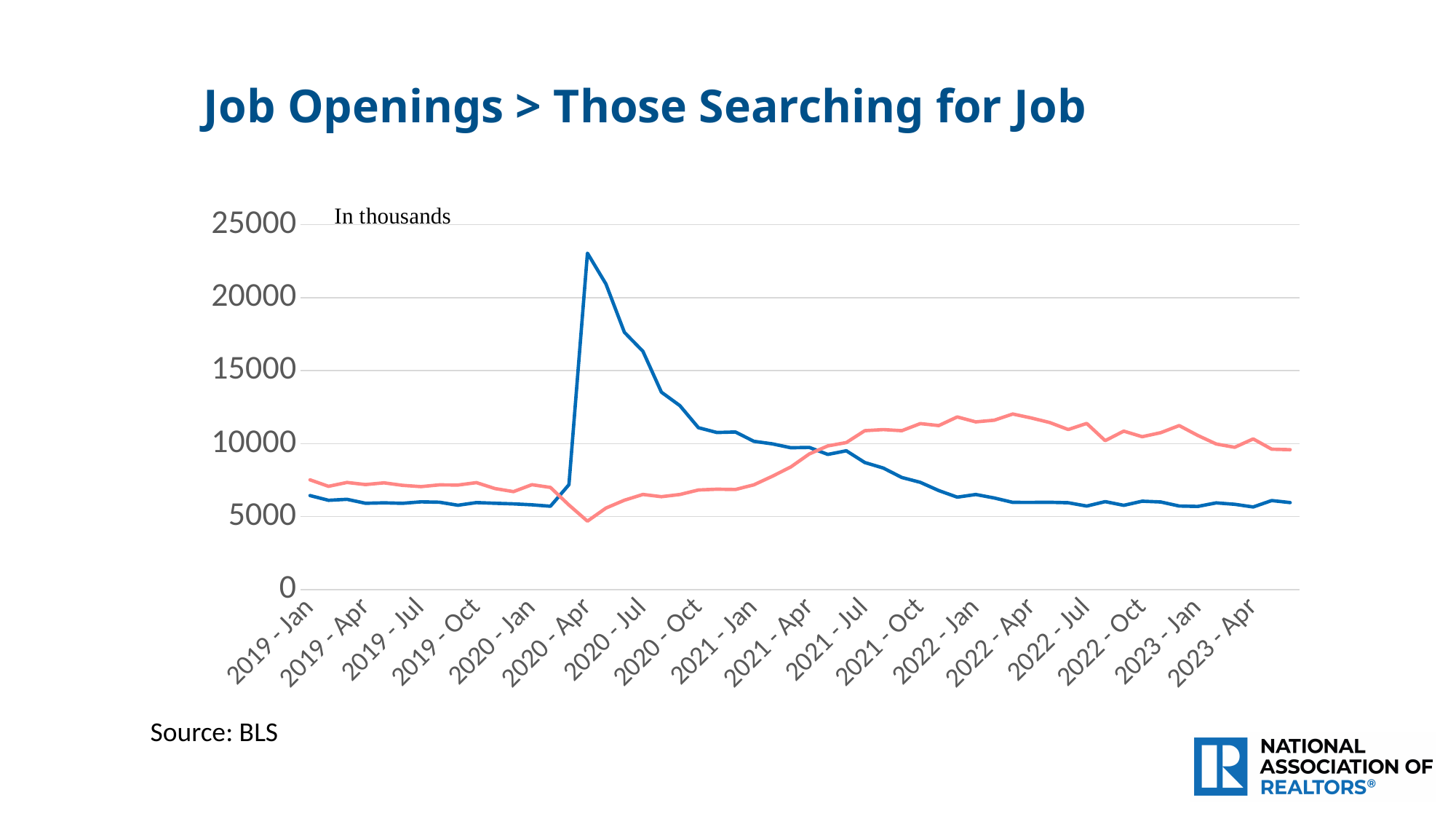
Is the value of the blue line at 2020 - Jul greater or less than 15000? greater At 2022 - Jan, which line has the larger value, the blue line or the pink line? the pink line At 2020 - Apr, which line has the larger value, the blue line or the pink line? the blue line Is the value of the pink line at 2020 - Apr greater or less than 5000? less How many labels are shown on the x axis? 18 What is the title of the chart? Job Openings > Those Searching for Job Does the blue line rise or fall between 2020 - Apr and 2021 - Jan? fall Is the value of the pink line at 2022 - Apr greater or less than 10000? greater How many lines are plotted on the chart? 2 What kind of chart is shown on the slide? Line chart In what unit are the values on the chart expressed, according to the note near the y axis? In thousands